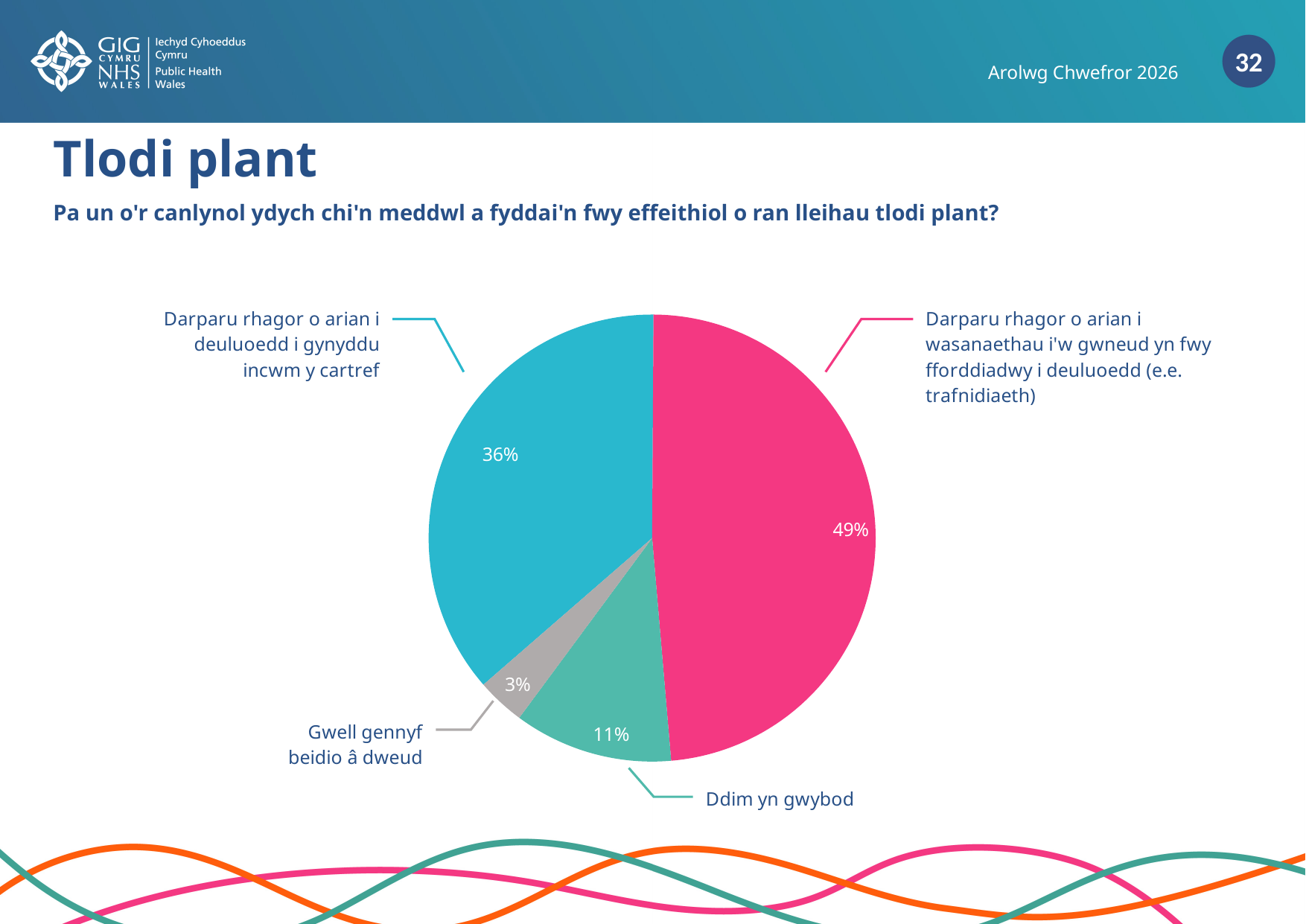
Which slice of the pie is the largest? Darparu rhagor o arian i wasanaethau i'w gwneud yn fwy fforddiadwy i deuluoedd (e.e. trafnidiaeth) What share of the pie is labelled 'Ddim yn gwybod'? 11% What share of the pie is labelled 'Darparu rhagor o arian i deuluoedd i gynyddu incwm y cartref'? 36% What share of the pie is labelled 'Gwell gennyf beidio â dweud'? 3% What share of the pie is labelled 'Darparu rhagor o arian i wasanaethau i'w gwneud yn fwy fforddiadwy i deuluoedd (e.e. trafnidiaeth)'? 49% What kind of chart is shown on the slide? pie chart Which slice of the pie is the smallest? Gwell gennyf beidio â dweud What is the difference in percentage points between the 'Ddim yn gwybod' slice and the 'Gwell gennyf beidio â dweud' slice? 8 percentage points Which is larger: the 'Ddim yn gwybod' slice or the 'Gwell gennyf beidio â dweud' slice? Ddim yn gwybod What colour is the slice labelled 'Ddim yn gwybod'? green What is the difference in percentage points between the 'Darparu rhagor o arian i wasanaethau' slice and the 'Darparu rhagor o arian i deuluoedd' slice? 13 percentage points How many slices does the pie chart have? 4